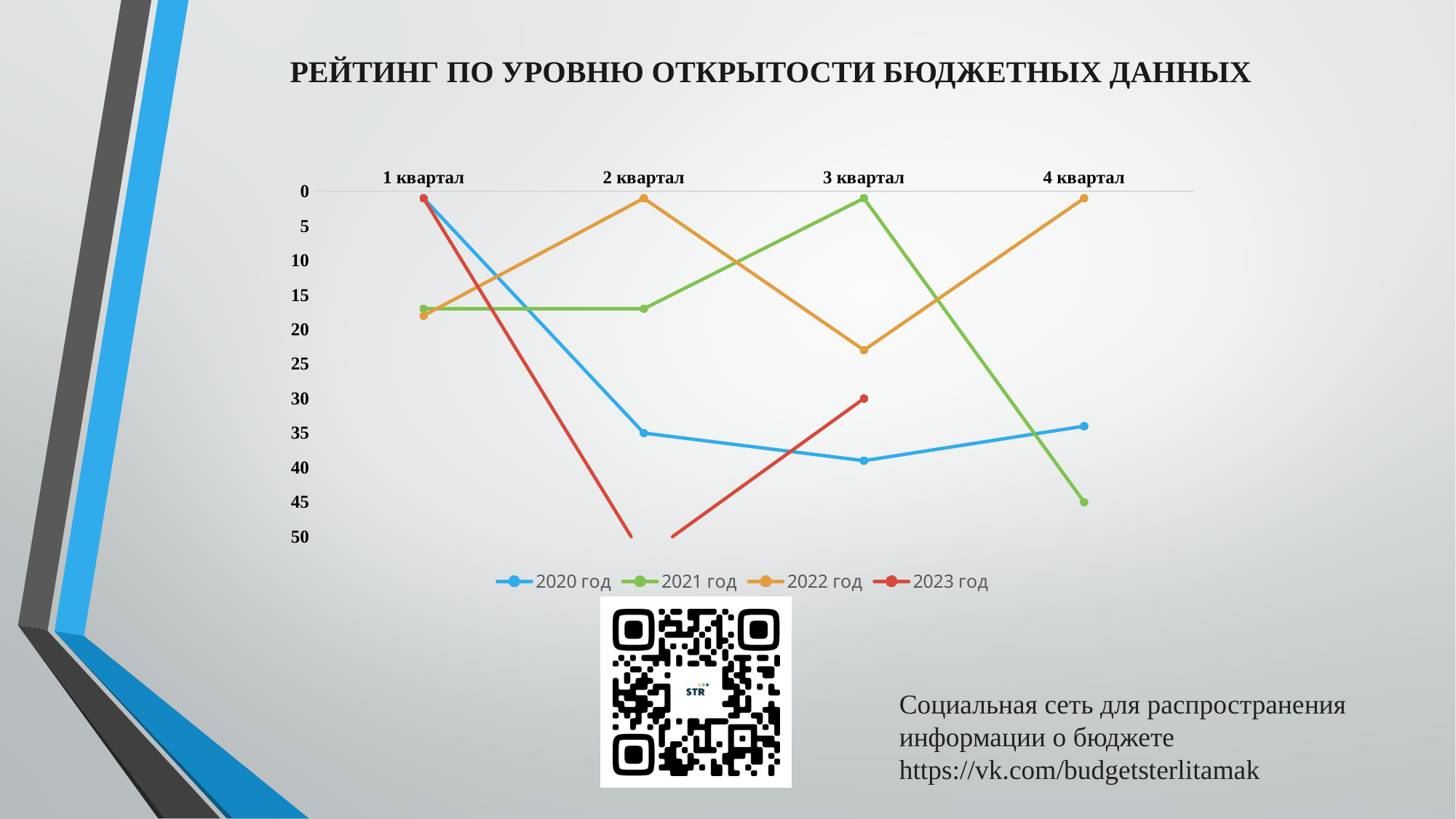
Is the value for 2023 год in 3 квартал greater or less than 25? greater In 4 квартал, which series has the larger value: 2020 год or 2021 год? 2021 год Which colour represents the 2022 год series in the legend? orange What kind of chart is shown on the slide? line chart Is the value for 2021 год in 1 квартал greater or less than 20? less What is the title of the chart? РЕЙТИНГ ПО УРОВНЮ ОТКРЫТОСТИ БЮДЖЕТНЫХ ДАННЫХ Is the value for 2022 год in 3 квартал greater or less than 20? greater In 3 квартал, which series has the larger value: 2020 год or 2022 год? 2020 год How many quarters (categories) are shown on the x axis? 4 How many series does the legend list? 4